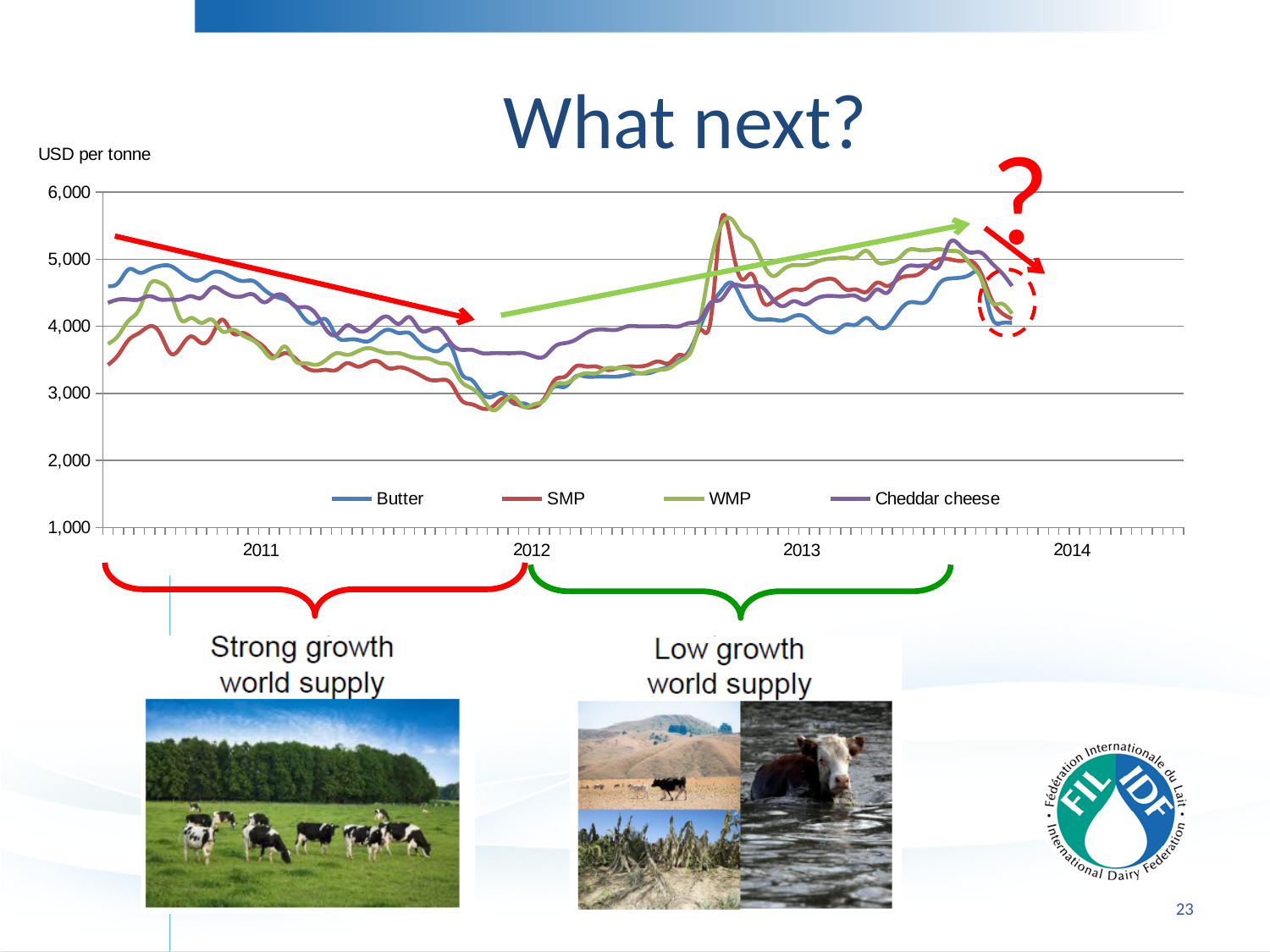
Is the Butter price at the start of 2011 greater or less than 4,000? greater Which series are listed in the chart's legend? Butter, SMP, WMP, Cheddar cheese Is the peak SMP price in 2013 greater or less than 5,000? greater How many series does the chart's legend list? 4 Is the lowest SMP price around the start of 2012 greater or less than 3,000? less What kind of chart is shown on the slide? line chart Do prices generally rise or fall between 2011 and 2012? fall How many year labels appear along the x axis of the chart? 4 Do prices generally rise or fall between 2012 and 2013? rise What unit is shown for the vertical axis of the chart? USD per tonne